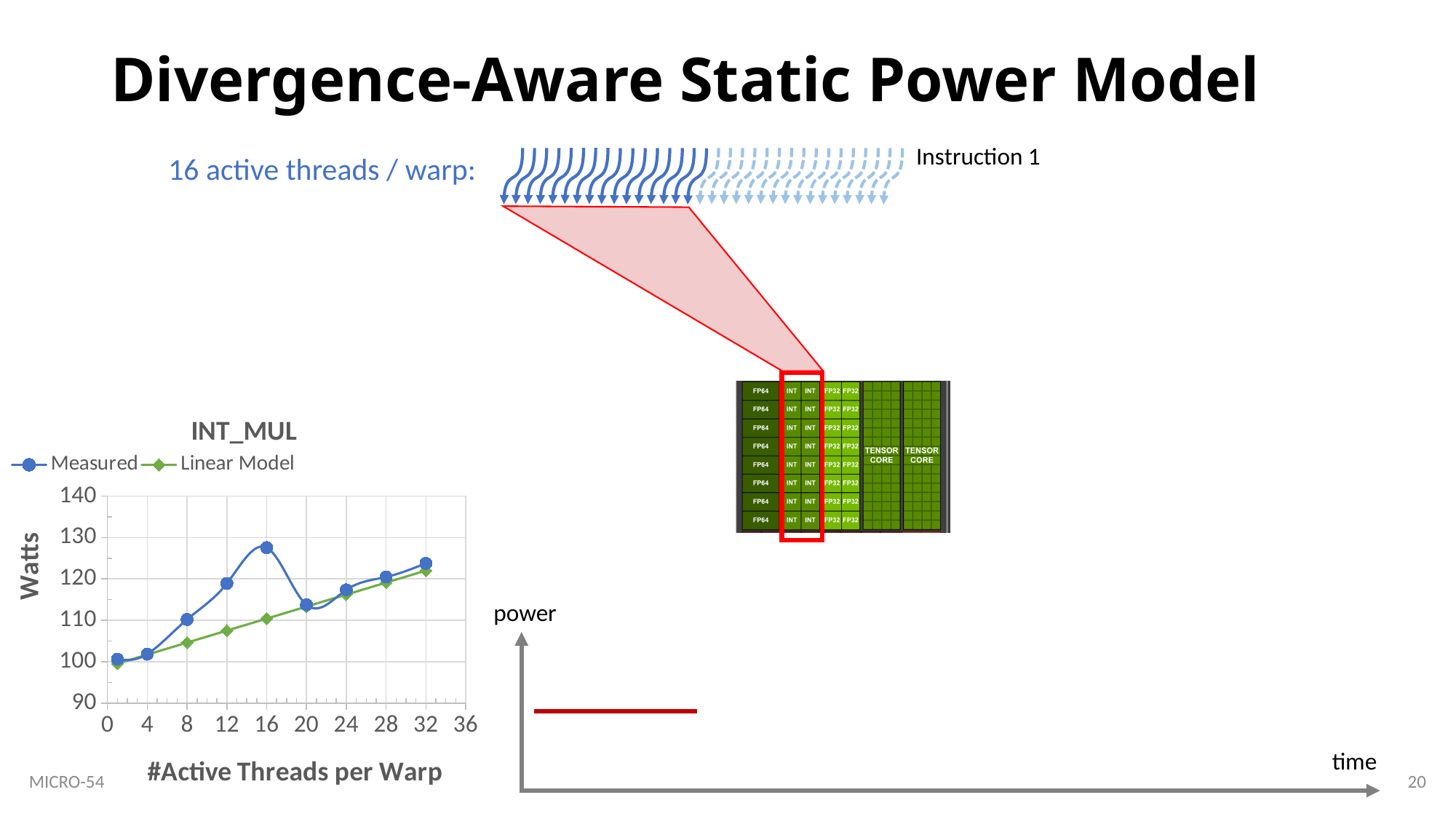
In the INT_MUL chart, is the Linear Model value at 8 active threads per warp greater or less than 110? less What is the y-axis label of the INT_MUL chart? Watts What is the title of the chart on the left of the slide? INT_MUL How many series does the legend of the INT_MUL chart list? 2 In the INT_MUL chart, is the Linear Model value at 32 active threads per warp greater or less than 120? greater In the INT_MUL chart, at 16 active threads per warp, which series has the larger value, Measured or Linear Model? Measured How many data points does the Linear Model series have in the INT_MUL chart? 9 In the INT_MUL chart, at which number of active threads per warp does the Measured series reach its highest value? 16 In the INT_MUL chart, does the Linear Model series rise or fall as the number of active threads per warp increases? rise In the INT_MUL chart, is the Measured value at 32 active threads per warp greater or less than 130? less What kind of chart is the INT_MUL chart? line chart